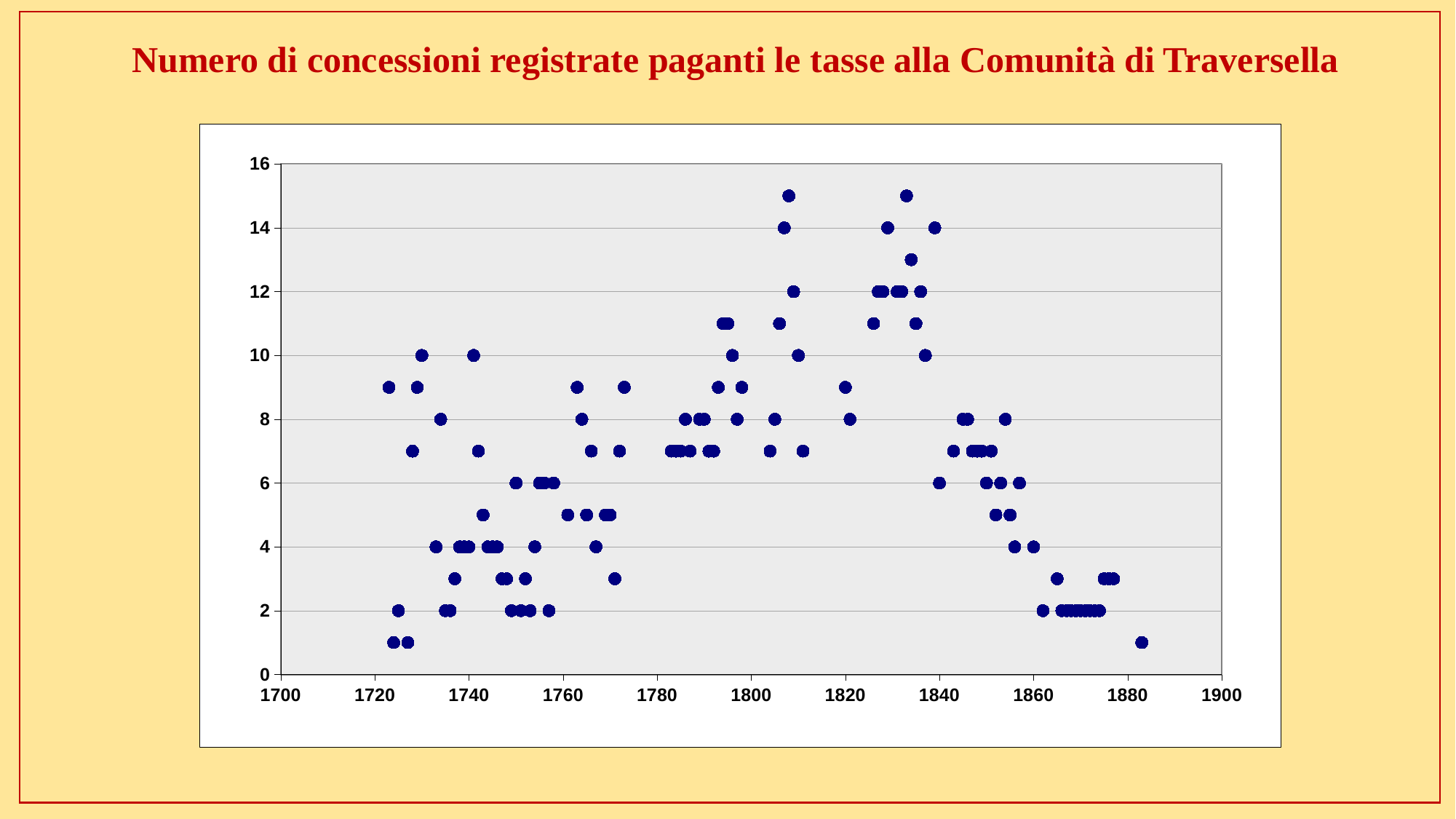
Is the value of the rightmost point (just after 1880) greater or less than 2? less What is the title of the chart? Numero di concessioni registrate paganti le tasse alla Comunità di Traversella Do the values generally rise or fall along the x axis after 1840? fall Which is larger: the highest value reached around 1808 or the highest value reached around 1770? the value around 1808 Is the highest point on the chart greater or less than 14? greater What is the maximum value shown on the vertical axis? 16 What kind of chart is shown on the slide? scatter chart